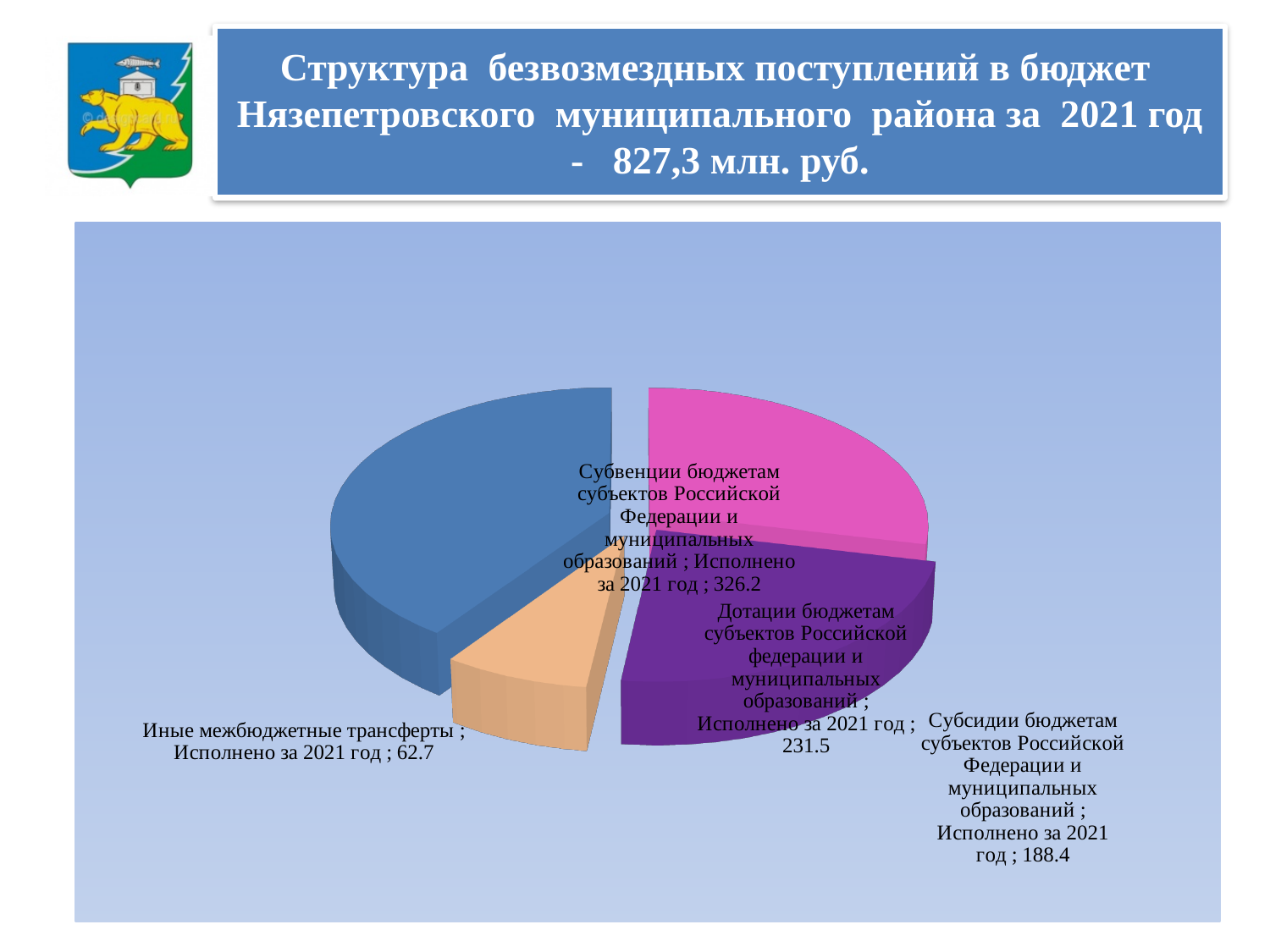
What kind of chart is shown on the slide? Pie chart What is the difference between the values for Субвенции (326.2) and Дотации (231.5)? 94.7 Which category has the lowest value? Иные межбюджетные трансферты What is the value for Субвенции бюджетам субъектов Российской Федерации и муниципальных образований? 326.2 What total amount in million rubles is stated in the slide title? 827,3 млн. руб. What is the value for Иные межбюджетные трансферты? 62.7 What is the difference between the values for Субсидии (188.4) and Иные межбюджетные трансферты (62.7)? 125.7 How many slices does the pie chart have? 4 Which is larger: the value for Дотации or the value for Субсидии? Дотации What is the value for Субсидии бюджетам субъектов Российской Федерации и муниципальных образований? 188.4 What is the value for Дотации бюджетам субъектов Российской федерации и муниципальных образований? 231.5 Which category has the highest value? Субвенции бюджетам субъектов Российской Федерации и муниципальных образований